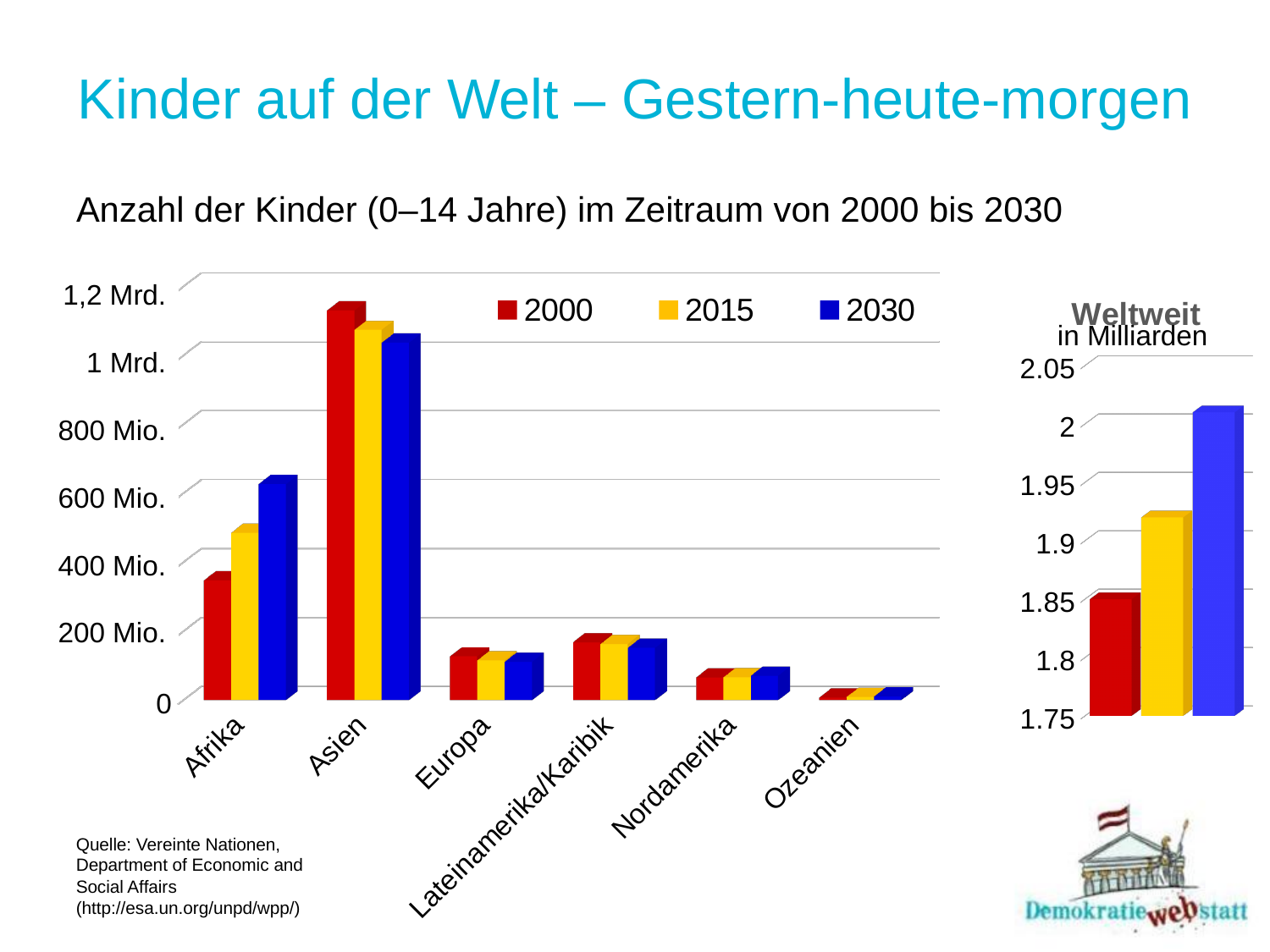
In the main chart on the left, do the values for Afrika rise or fall from 2000 to 2030? rise In the main chart on the left, do the values for Asien rise or fall from 2000 to 2030? fall In the main chart on the left, which is larger in 2030: Afrika or Lateinamerika/Karibik? Afrika In the main chart on the left, which region has the highest value for 2000? Asien In the main chart on the left, which region has the lowest value for 2030? Ozeanien In the main chart on the left, is the value for Asien in 2000 greater or less than 1 Mrd.? greater In the main chart on the left, is the value for Afrika in 2030 greater or less than 400 Mio.? greater In the main chart on the left, how many regions are shown on the x axis? 6 In the main chart on the left, is the value for Europa in 2000 greater or less than 200 Mio.? less In the main chart on the left, how many series does the legend list? 3 What kind of chart is the main chart on the left showing the number of children by region? bar chart